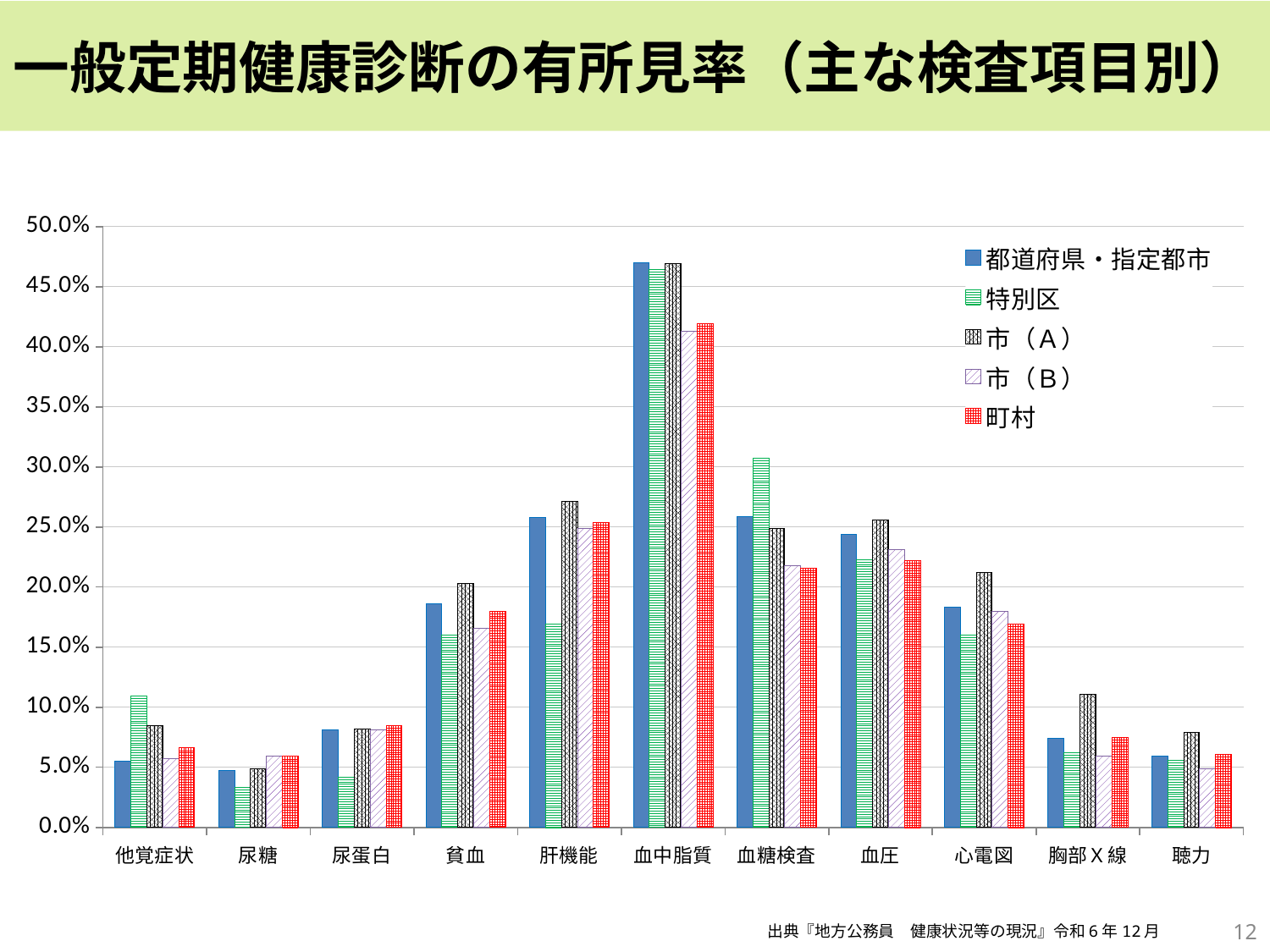
Which category has the highest values across all series? 血中脂質 What kind of chart is shown on the slide? bar chart How many series does the legend list? 5 In 肝機能, which is larger: 市（A） or 特別区? 市（A） Is the value for 特別区 in 血糖検査 greater or less than 25.0%? greater Which category has the lowest values overall? 尿糖 How many categories are shown along the x axis? 11 Is the value for 都道府県・指定都市 in 血中脂質 greater or less than 45.0%? greater Is the value for 町村 in 聴力 greater or less than 10.0%? less In 血糖検査, which is larger: 特別区 or 都道府県・指定都市? 特別区 Which series is shown in solid blue in the legend? 都道府県・指定都市